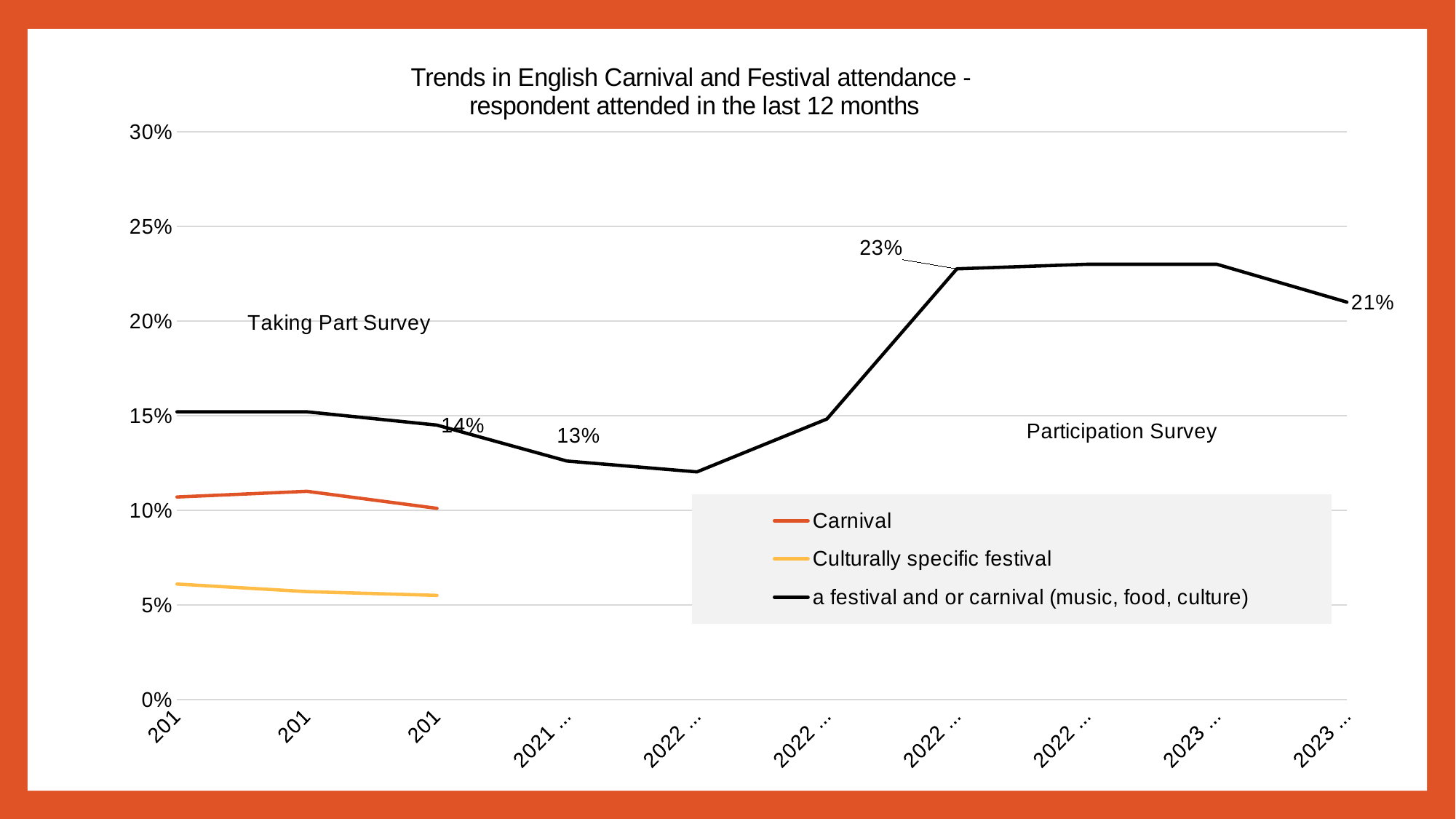
Does the Culturally specific festival line rise or fall along the x axis? fall Which series is higher, Carnival or Culturally specific festival? Carnival What is the title of the chart? Trends in English Carnival and Festival attendance - respondent attended in the last 12 months What kind of chart is shown on the slide? line chart Which series has the lowest values on the chart? Culturally specific festival How many series does the legend list? 3 Are the values for the Culturally specific festival line greater or less than 10%? less What is the highest labelled value on the 'a festival and or carnival (music, food, culture)' line? 23% What value is labelled at the rightmost point of the 'a festival and or carnival (music, food, culture)' line? 21% Which series has the highest values on the chart? a festival and or carnival (music, food, culture) What is the difference between the 14% and 13% labelled values on the 'a festival and or carnival (music, food, culture)' line? 1% What is the difference between the 23% and 21% labelled values on the 'a festival and or carnival (music, food, culture)' line? 2%